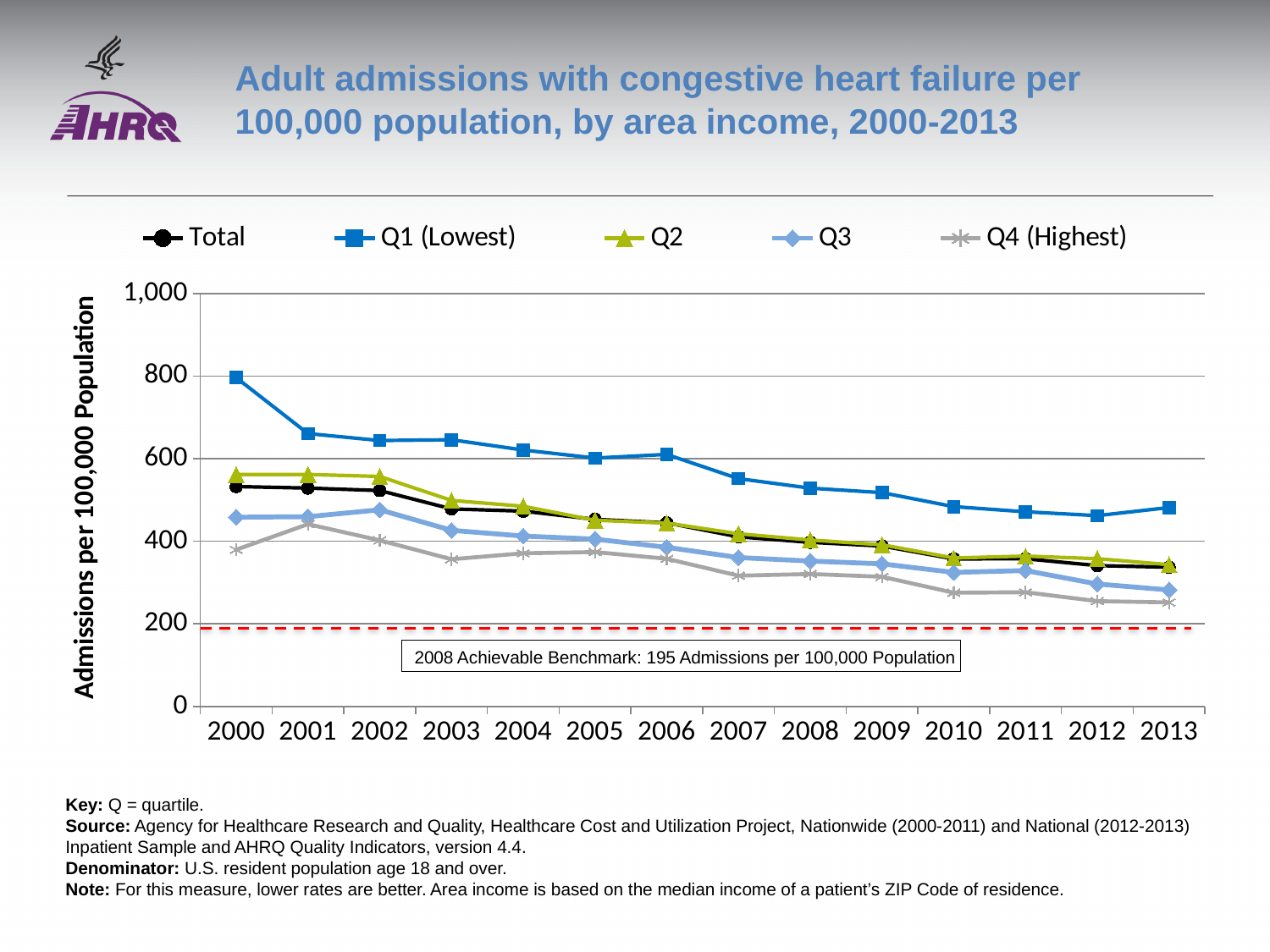
Is the value for Q4 (Highest) in 2013 greater or less than 400? less What kind of chart is shown on the slide? Line chart Does the Q1 (Lowest) series rise or fall from 2000 to 2013? Fall Is the value for Q1 (Lowest) in 2013 greater or less than 600? less What is the label of the y axis? Admissions per 100,000 Population Is the value for Q1 (Lowest) in 2000 greater or less than 600? greater In 2005, which is larger: the value for Q1 (Lowest) or the value for Q4 (Highest)? Q1 (Lowest) Which series has the highest value in 2000? Q1 (Lowest) How many series does the legend list? 5 Which series has the lowest value in 2013? Q4 (Highest) What is the 2008 achievable benchmark shown on the chart? 195 Admissions per 100,000 Population How many years are plotted along the x axis? 14